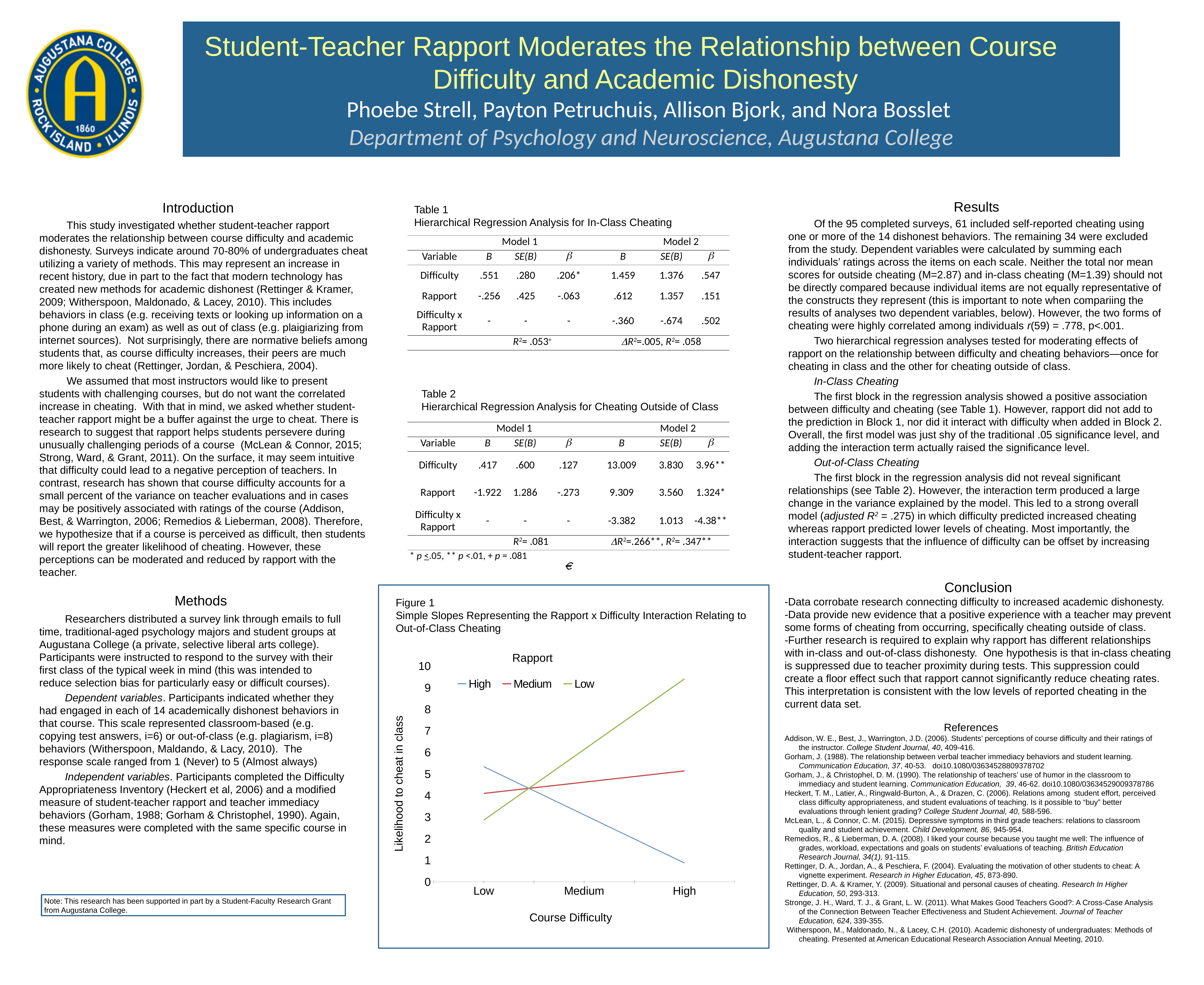
In Figure 1, which rapport series has the highest likelihood to cheat at High course difficulty? Low How many course difficulty categories are shown on the x axis of Figure 1? 3 In Figure 1, which rapport series has the lowest likelihood to cheat at High course difficulty? High In Figure 1, at Low course difficulty, which series is larger: High rapport or Low rapport? High In Figure 1, does the High rapport line rise or fall as course difficulty increases from Low to High? fall What kind of chart is Figure 1? line chart How many series does the legend of Figure 1 list? 3 In Figure 1, does the Low rapport line rise or fall as course difficulty increases from Low to High? rise In Figure 1, is the value for the Low rapport series at High course difficulty greater or less than 8? greater In Figure 1, is the value for the High rapport series at High course difficulty greater or less than 2? less What is the y-axis label of the chart in Figure 1? Likelihood to cheat in class In Figure 1, is the value for the Low rapport series at Low course difficulty greater or less than 4? less